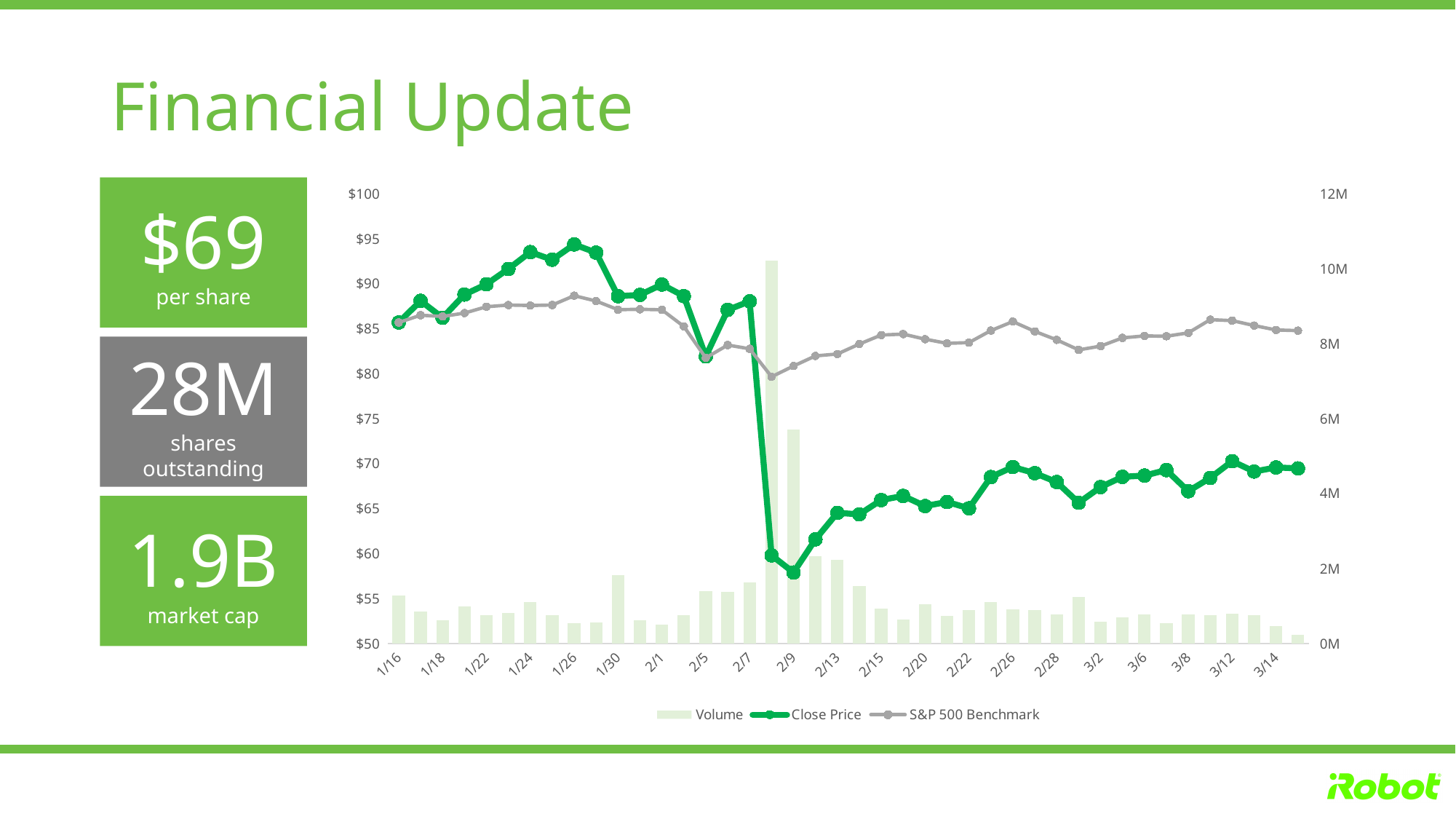
Which is higher, the Close Price on 1/26 or the Close Price on 3/14? 1/26 Is the tallest Volume bar greater or less than 8M? greater What kind of chart is shown on the slide? Combination chart with bars (Volume) and two lines (Close Price, S&P 500 Benchmark) Is the Close Price on 3/14 greater or less than $75? less Is the S&P 500 Benchmark value on 2/9 greater or less than $85? less Which series is drawn as bars in the chart? Volume Does the Close Price rise or fall between 2/7 and 2/9? Fall How many series does the chart legend list? 3 What colour is the Close Price line in the chart? Green How many date labels are shown on the x axis of the chart? 21